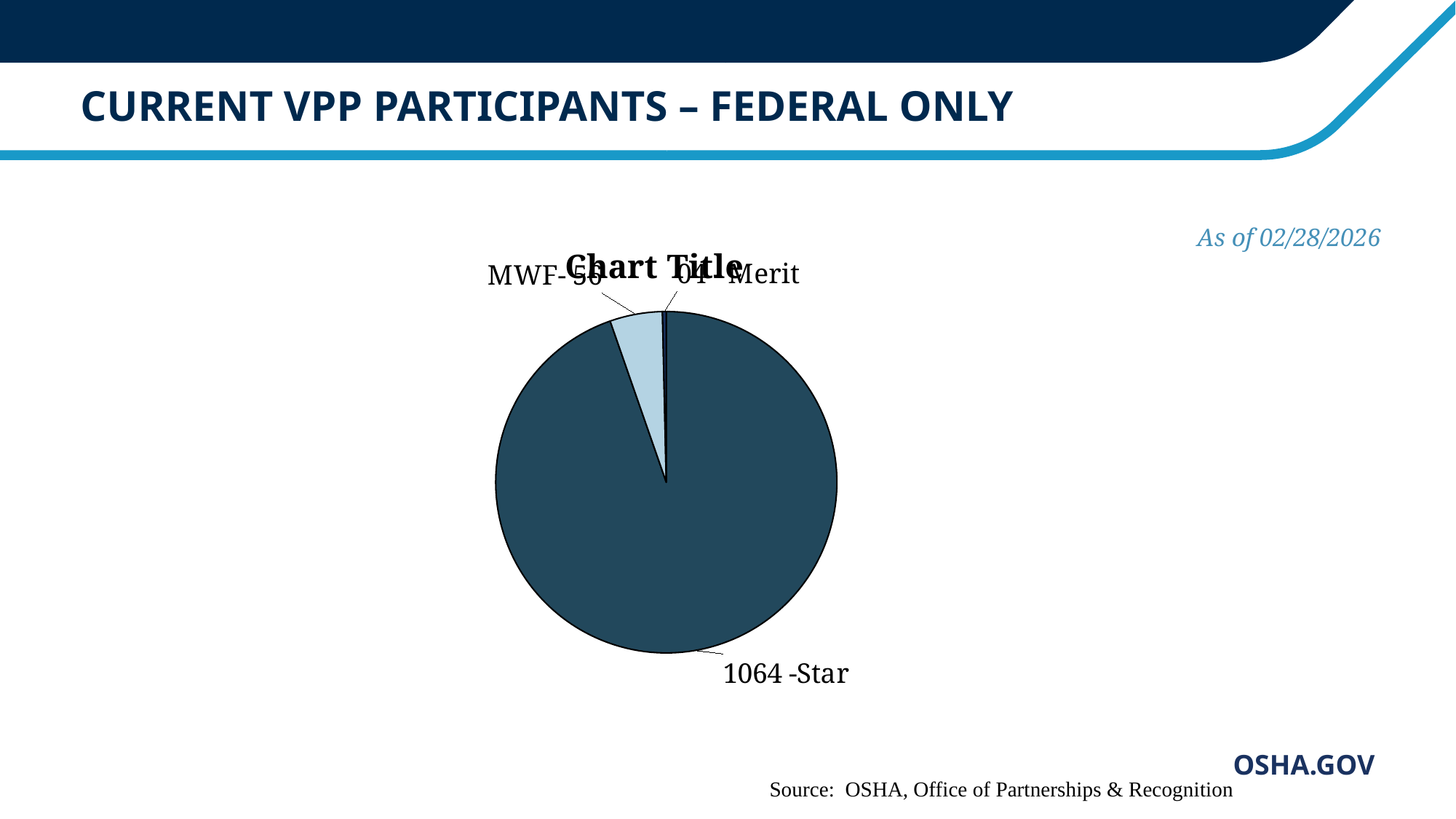
Which slice is larger in the pie chart, MWF or Merit? MWF Which category has the largest slice of the pie chart? Star Is the value for the Star slice greater or less than 1000? greater What title is printed above the pie chart? Chart Title What is the value shown for the Star slice of the pie chart? 1064 Which category has the smallest slice of the pie chart? Merit What is the title of the slide containing the pie chart? CURRENT VPP PARTICIPANTS – FEDERAL ONLY What kind of chart is shown on the slide? pie chart How many slices does the pie chart have? 3 Which slice is larger in the pie chart, Star or MWF? Star